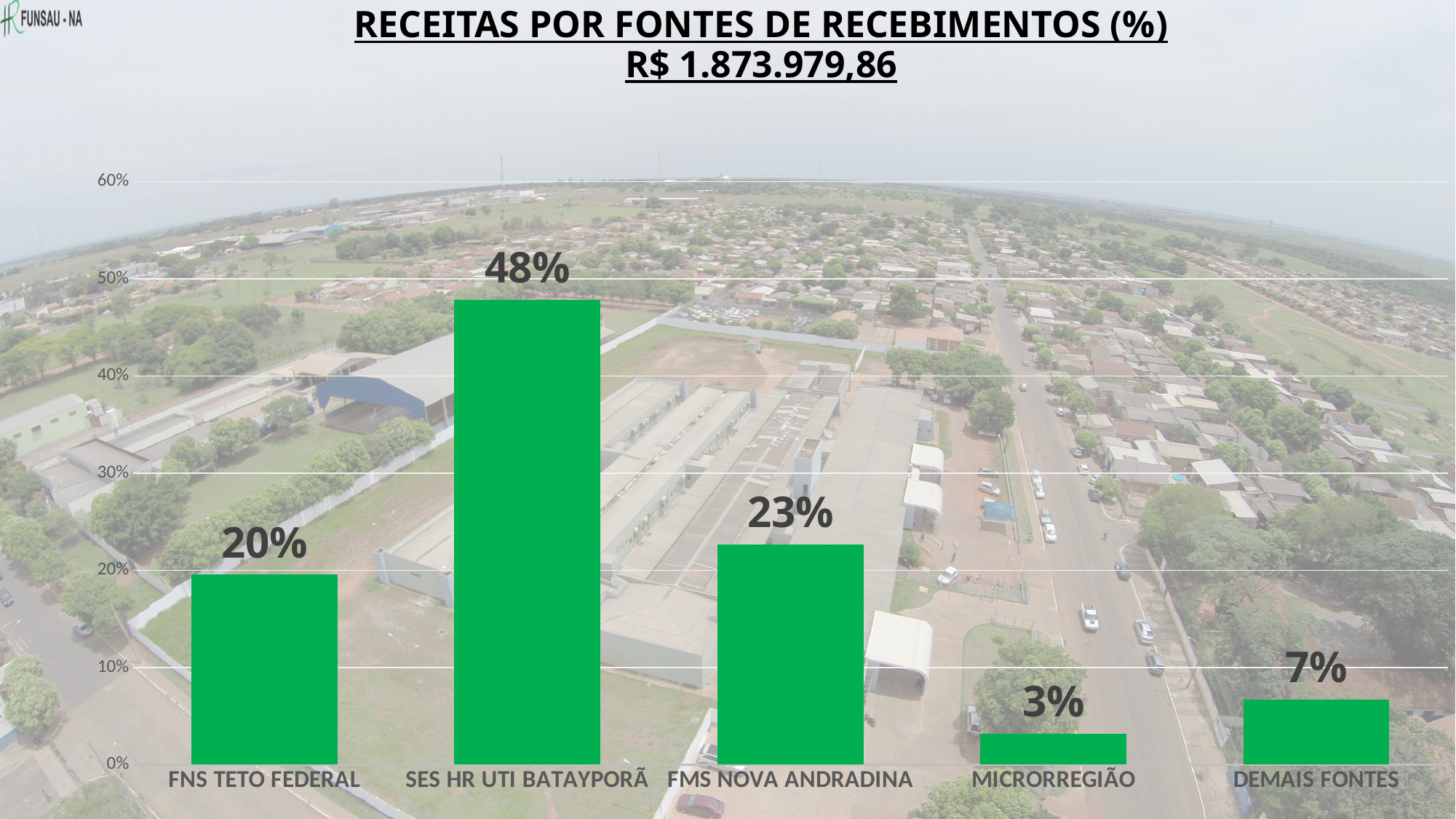
What total amount in R$ is shown in the chart title? R$ 1.873.979,86 What is the value for FMS NOVA ANDRADINA? 23% Which is larger, the value for FNS TETO FEDERAL or the value for FMS NOVA ANDRADINA? FMS NOVA ANDRADINA What is the value for MICRORREGIÃO? 3% Which category has the highest value? SES HR UTI BATAYPORÃ What is the value for SES HR UTI BATAYPORÃ? 48% Which category has the lowest value? MICRORREGIÃO What is the difference between the values for SES HR UTI BATAYPORÃ and FMS NOVA ANDRADINA? 25% How many categories are shown in the chart? 5 What kind of chart is shown on the slide? Bar chart What is the value for FNS TETO FEDERAL? 20% What is the value for DEMAIS FONTES? 7%